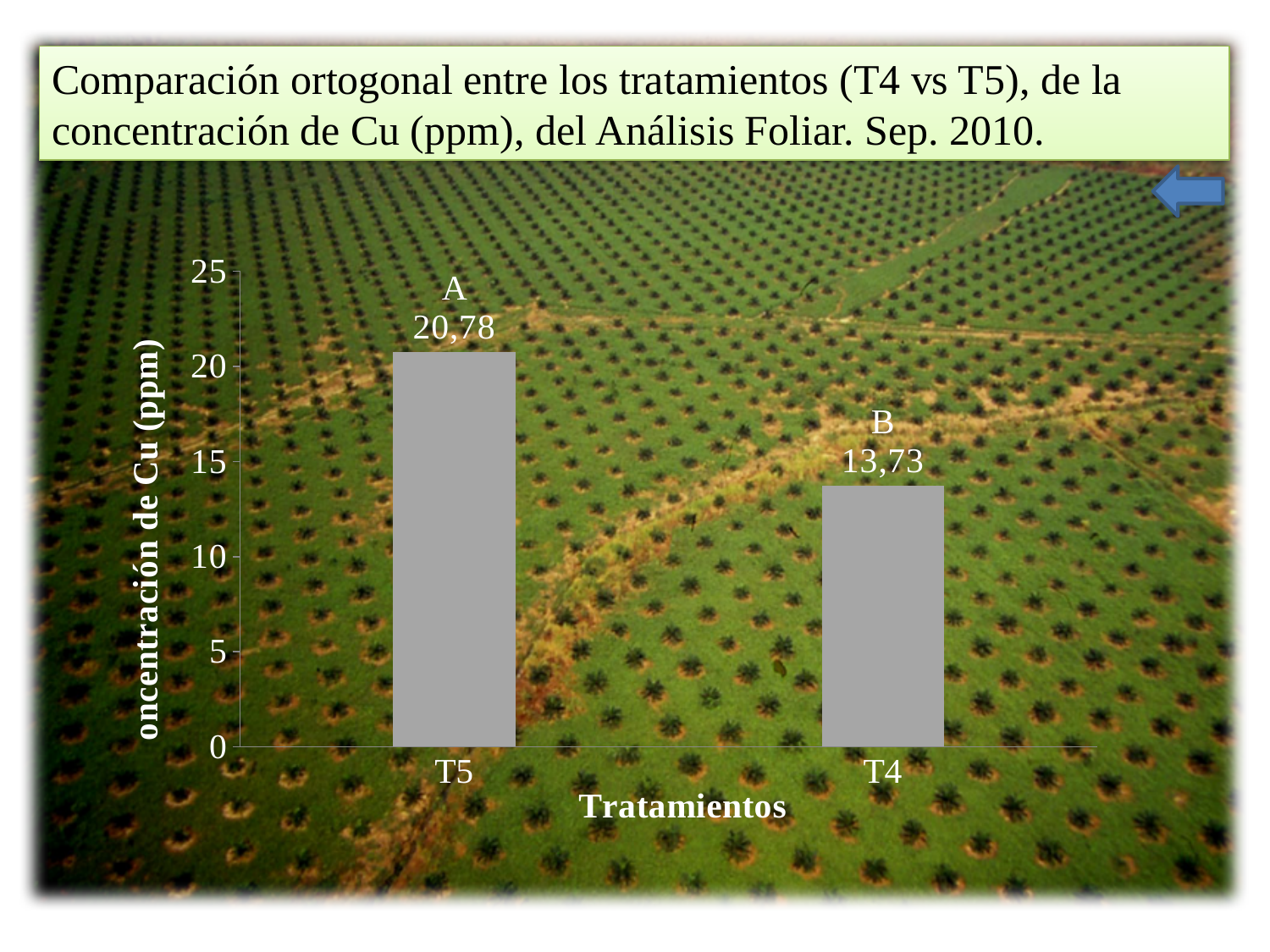
What is the label on the x axis of the chart? Tratamientos What is the difference between the Cu concentration of T5 and T4? 7,05 What is the Cu concentration value shown for treatment T5? 20,78 What kind of chart is shown on the slide? bar chart Is the value for T5 greater or less than 20? greater How many treatments are plotted on the chart? 2 Which treatment has a larger Cu concentration, T4 or T5? T5 Is the value for T4 greater or less than 15? less Which treatment has the lowest Cu concentration? T4 Which treatment has the highest Cu concentration? T5 What is the Cu concentration value shown for treatment T4? 13,73 Which letter is printed above the bar for T4? B